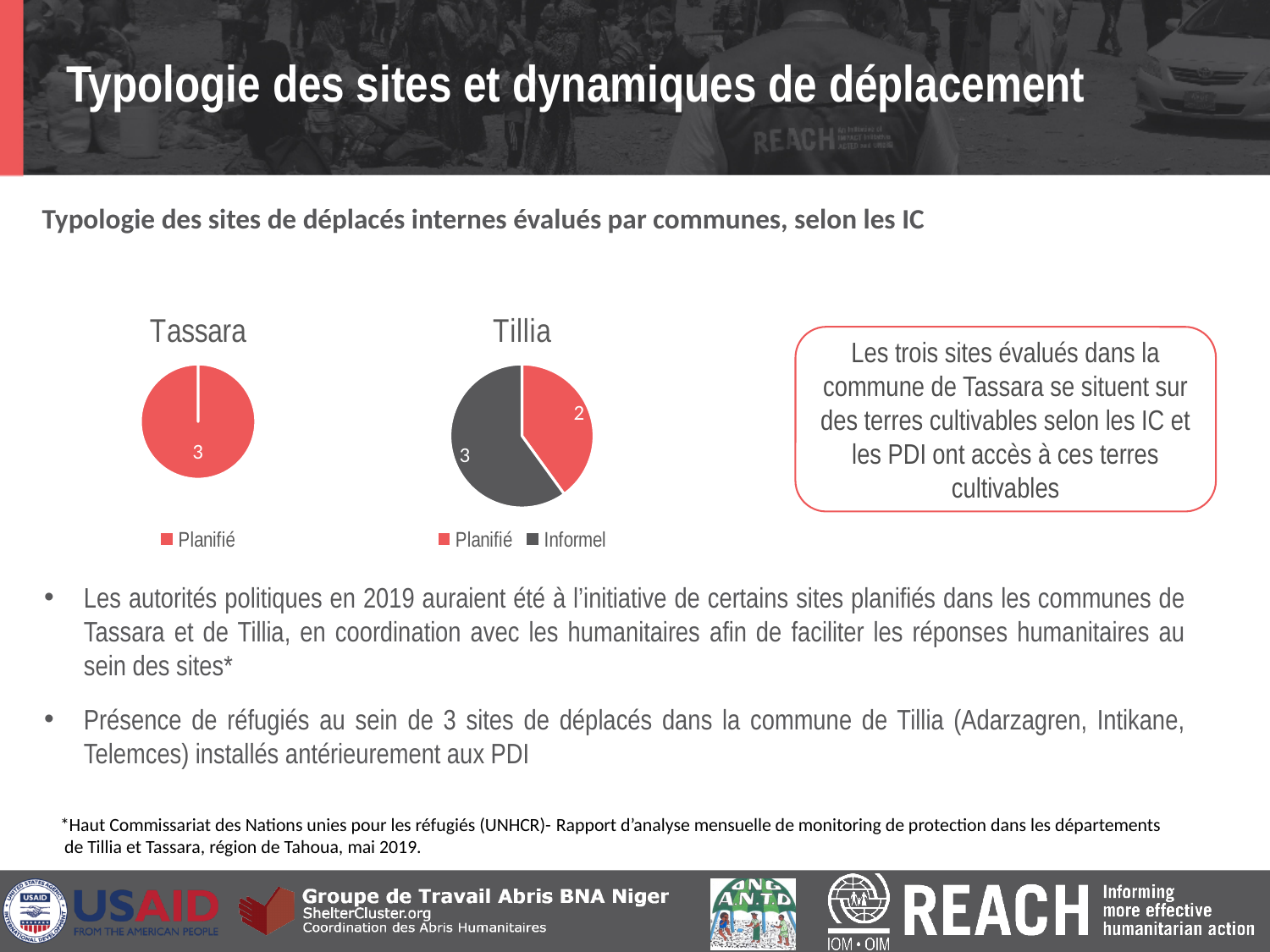
In the "Tillia" chart, what is the value for Informel? 3 How many categories does the legend of the "Tillia" chart list? 2 In the "Tillia" chart, which is larger, Planifié or Informel? Informel In the "Tillia" chart, which category has the smallest slice? Planifié In the "Tillia" chart, what colour is the Informel slice? dark grey How many categories does the legend of the "Tassara" chart list? 1 In the "Tillia" chart, what is the difference between the Informel and Planifié values? 1 What type of chart is the "Tassara" chart? pie chart In the "Tillia" chart, what is the total of all slices? 5 In the "Tassara" chart, what is the value for Planifié? 3 In the "Tillia" chart, what is the value for Planifié? 2 In the "Tillia" chart, which category has the largest slice? Informel